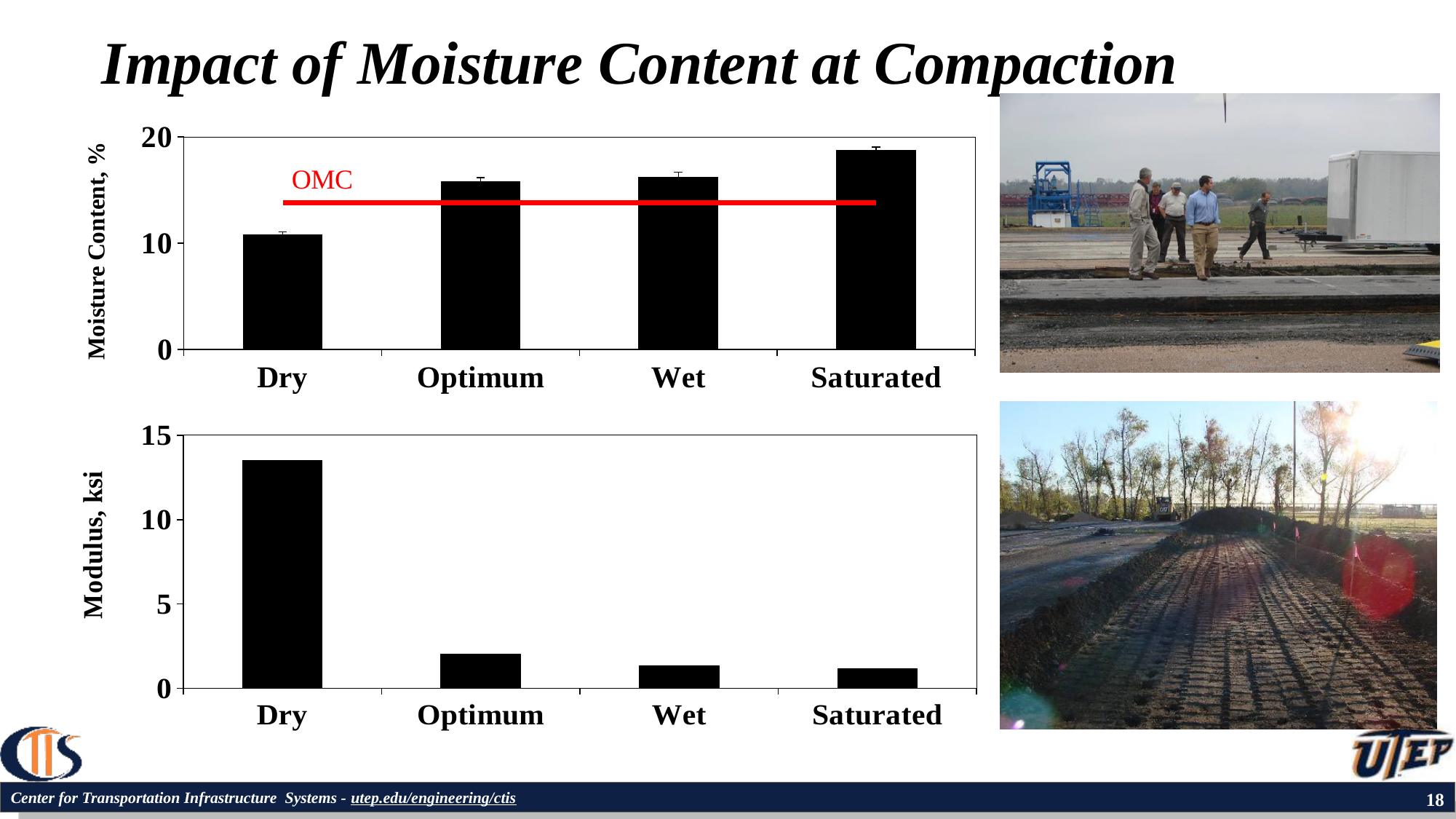
In the top chart (Moisture Content, %), which is larger, the moisture content for Dry or for Saturated? Saturated In the bottom chart (Modulus, ksi), which is larger, the modulus for Dry or for Optimum? Dry In the top chart (Moisture Content, %), is the moisture content for Saturated greater or less than 20? less In the top chart (Moisture Content, %), which category has the highest moisture content? Saturated In the top chart (Moisture Content, %), which category has the lowest moisture content? Dry In the bottom chart (Modulus, ksi), which category has the highest modulus? Dry What is the label of the red horizontal line in the top chart? OMC What kind of chart is the top chart (Moisture Content, %)? bar chart In the bottom chart (Modulus, ksi), is the modulus for Optimum greater or less than 5? less In the top chart (Moisture Content, %), do the values rise or fall from Dry to Saturated along the x axis? rise How many categories are shown on the x axis of the bottom chart (Modulus, ksi)? 4 In the bottom chart (Modulus, ksi), is the modulus for Dry greater or less than 10? greater